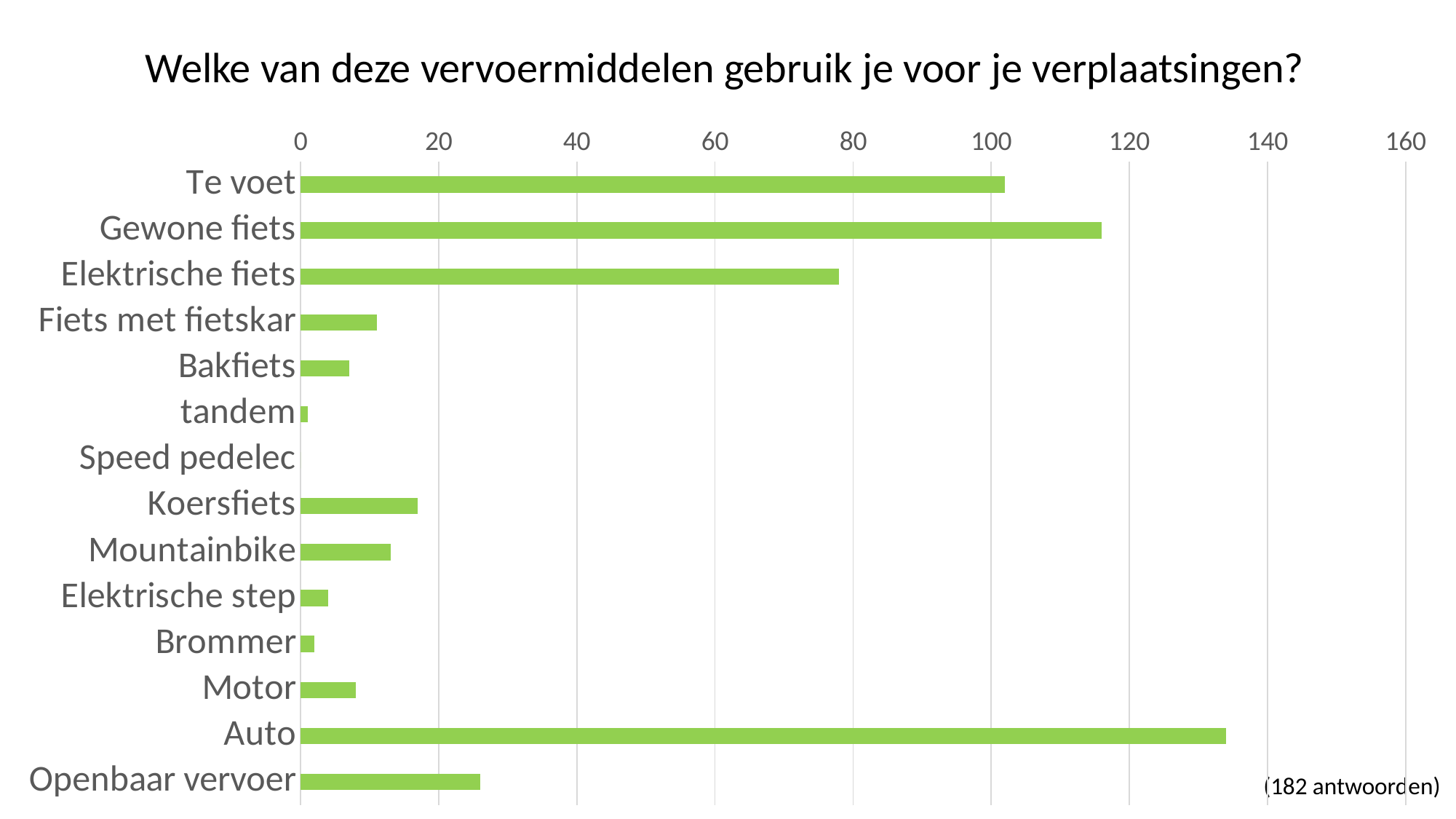
Which category has the lowest value? Speed pedelec Which is larger, the value for Koersfiets or the value for Mountainbike? Koersfiets Which category has the highest value? Auto Is the value for Gewone fiets greater or less than 100? greater Is the value for Elektrische fiets greater or less than 60? greater Is the value for Auto greater or less than 120? greater What is the title of the chart? Welke van deze vervoermiddelen gebruik je voor je verplaatsingen? Which is larger, the value for Te voet or the value for Elektrische fiets? Te voet How many categories (vervoermiddelen) are listed on the chart? 14 What kind of chart is shown on the slide? bar chart How many responses does the note in the bottom right corner say the chart is based on? 182